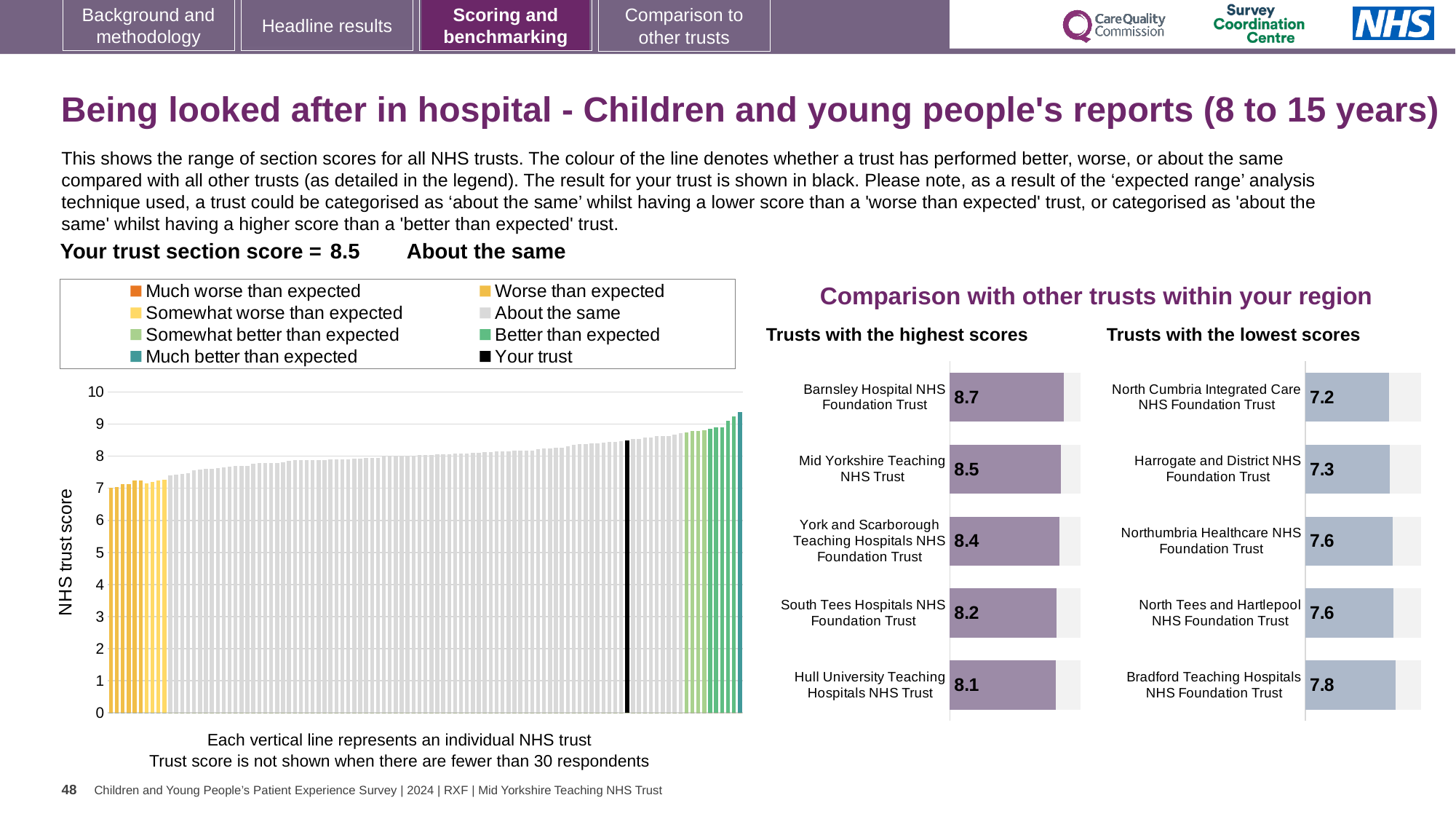
In the 'Trusts with the lowest scores' chart, what is the score for North Cumbria Integrated Care NHS Foundation Trust? 7.2 How many entries does the legend of the left-hand NHS trust score chart list? 8 What kind of chart is the large chart on the left showing NHS trust scores? Bar chart In the 'Trusts with the lowest scores' chart, which trust has the lowest score? North Cumbria Integrated Care NHS Foundation Trust In the left-hand NHS trust score chart, do the trust scores rise or fall from left to right? Rise In the left-hand NHS trust score chart, what is the section score for your trust? 8.5 In the 'Trusts with the highest scores' chart, which trust has the highest score? Barnsley Hospital NHS Foundation Trust In the 'Trusts with the highest scores' chart, what is the difference between the scores of Barnsley Hospital NHS Foundation Trust and Hull University Teaching Hospitals NHS Trust? 0.6 In the 'Trusts with the lowest scores' chart, what is the difference between the scores of Bradford Teaching Hospitals NHS Foundation Trust and North Cumbria Integrated Care NHS Foundation Trust? 0.6 How many trusts are shown in the 'Trusts with the highest scores' chart? 5 In the 'Trusts with the lowest scores' chart, which has the larger score: Harrogate and District NHS Foundation Trust or Bradford Teaching Hospitals NHS Foundation Trust? Bradford Teaching Hospitals NHS Foundation Trust In the 'Trusts with the highest scores' chart, what is the score for Barnsley Hospital NHS Foundation Trust? 8.7